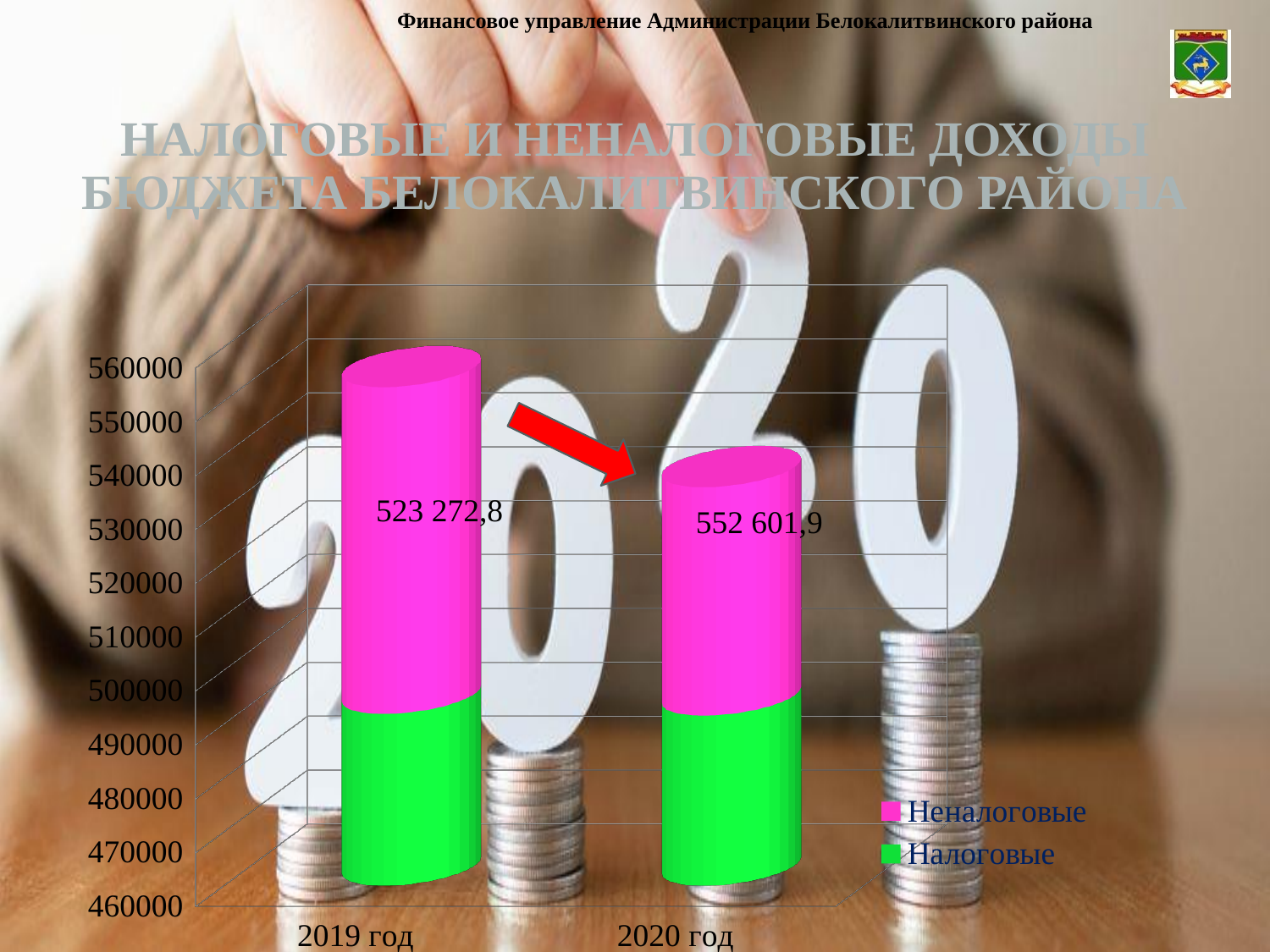
What kind of chart is shown on the slide? Stacked bar chart Is the top of the stacked bar for 2019 год greater or less than 550000? greater What are the two series listed in the chart legend? Неналоговые and Налоговые How many categories are shown on the x axis of the chart? 2 What value is labelled on the bar for 2020 год? 552 601,9 What is the title of the chart on the slide? НАЛОГОВЫЕ И НЕНАЛОГОВЫЕ ДОХОДЫ БЮДЖЕТА БЕЛОКАЛИТВИНСКОГО РАЙОНА Is the top of the stacked bar for 2020 год greater or less than 550000? less What value is labelled on the bar for 2019 год? 523 272,8 How many series does the chart legend list? 2 Is the top of the Налоговые segment for 2019 год greater or less than 490000? greater